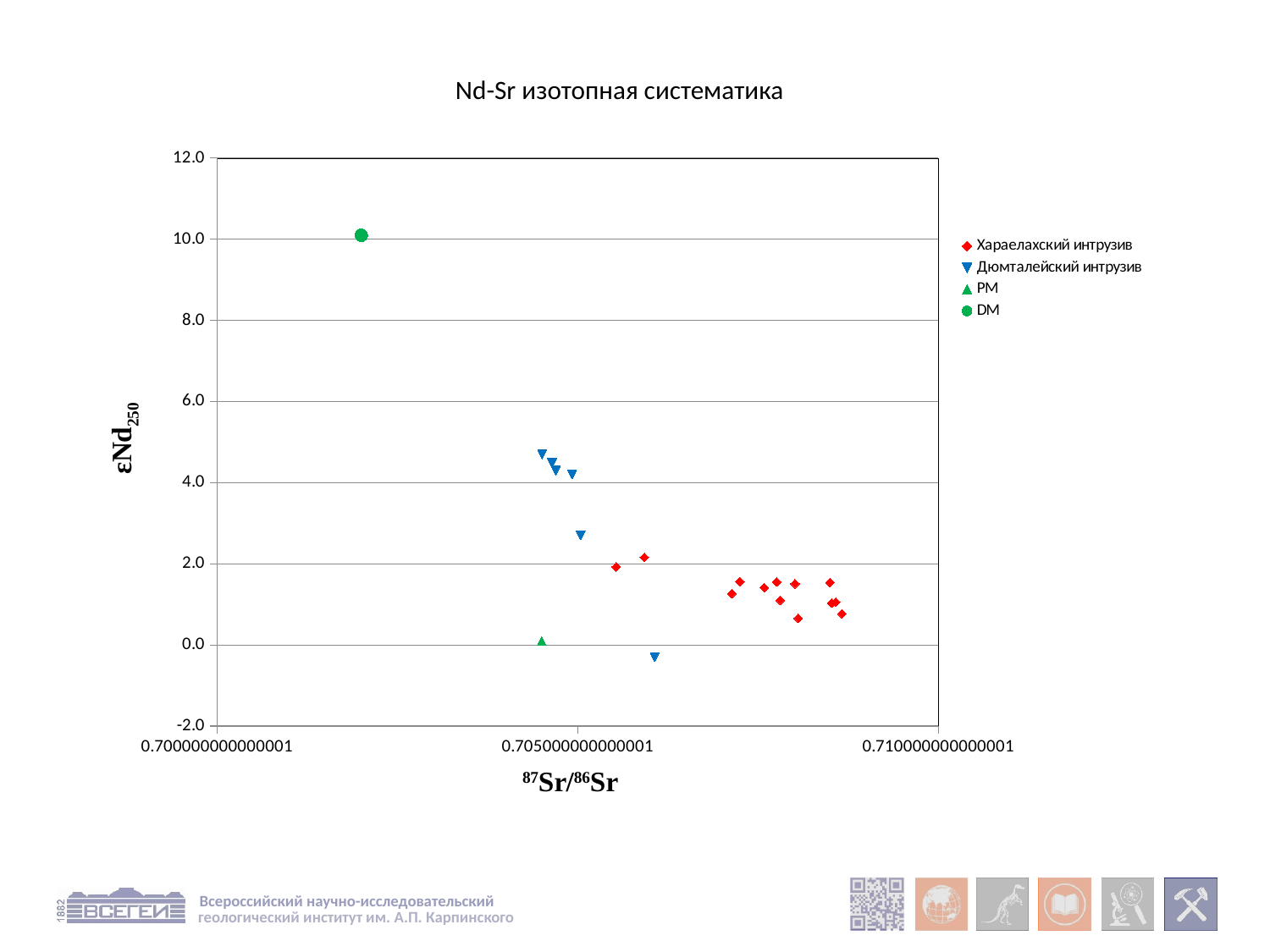
What kind of chart is shown on the slide? scatter chart What is the title of the chart? Nd-Sr изотопная систематика Is the εNd250 value of the PM point greater or less than 2.0? less Which has a higher εNd250 value, the DM point or the PM point? DM How many points are plotted for the DM series? 1 Are all εNd250 values of the Хараелахский интрузив series greater or less than 4.0? less Which series has the highest plotted point on the chart? DM Is the highest εNd250 value of the Дюмталейский интрузив series greater or less than 4.0? greater How many series does the legend list? 4 Which series contains the lowest plotted point on the chart? Дюмталейский интрузив What is the label of the vertical axis? εNd250